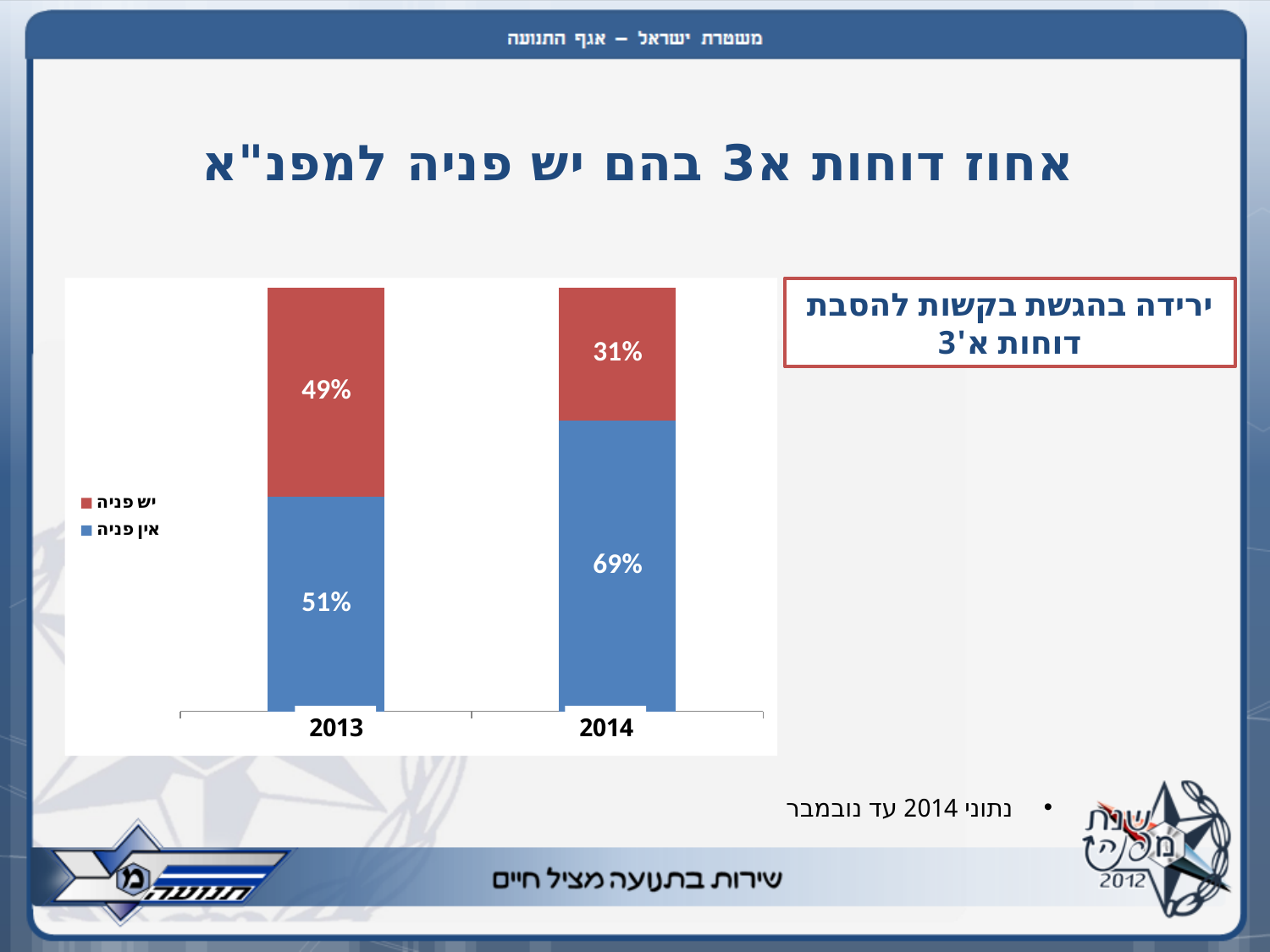
What kind of chart is shown on the slide? Stacked bar chart What percentage does the "אין פניה" series show for 2013? 51% What percentage does the "אין פניה" series show for 2014? 69% What percentage does the "יש פניה" series show for 2014? 31% In which year is the "יש פניה" share higher? 2013 What percentage does the "יש פניה" series show for 2013? 49% How many series does the legend list? 2 By how many percentage points did the "יש פניה" share fall from 2013 to 2014? 18 Which is larger: the "אין פניה" share in 2014 or the "אין פניה" share in 2013? 2014 In which year is the "אין פניה" share lower? 2013 How many years (categories) are shown on the x axis? 2 Which colour represents the "יש פניה" series? Red